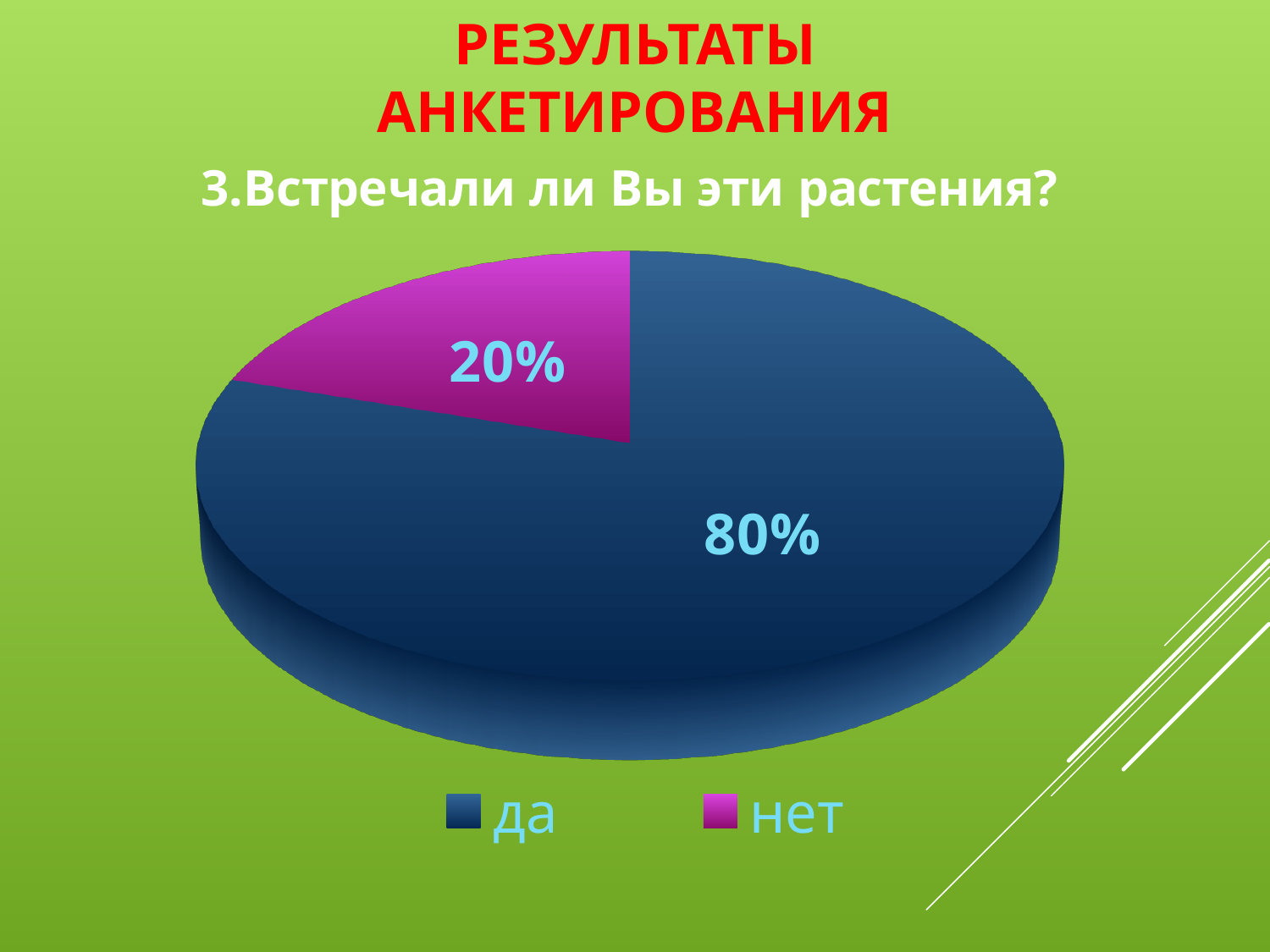
What is the difference in percentage points between the "да" and "нет" slices? 60 percentage points What kind of chart is shown on the slide? pie chart How many slices does the pie chart have? 2 What question does the chart present results for? 3.Встречали ли Вы эти растения? Is the share for "да" greater or less than 50%? greater Which slice is the largest in the pie chart? да What share of the pie does the "нет" slice represent? 20% What colour is the "нет" slice in the pie chart? magenta Which is larger, the "да" slice or the "нет" slice? да Which slice is the smallest in the pie chart? нет What share of the pie does the "да" slice represent? 80% How many entries does the legend list? 2